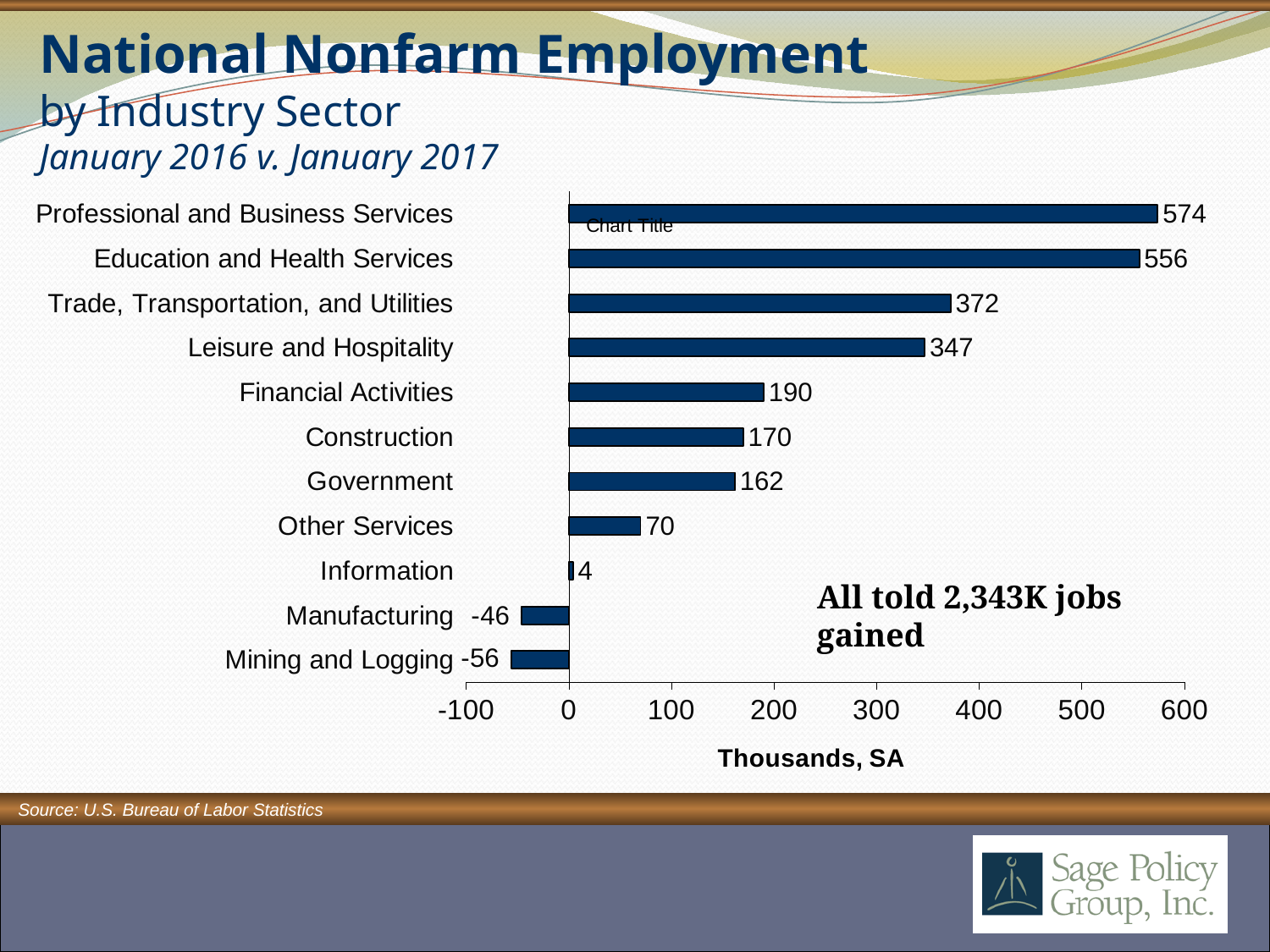
How many industry sectors are shown in the chart? 11 Which industry sector has the lowest value? Mining and Logging Which is larger, the value for Construction or the value for Government? Construction What kind of chart is shown on the slide? bar chart Which industry sector has the highest value? Professional and Business Services What is the difference between the values for Professional and Business Services and Education and Health Services? 18 Is the value for Financial Activities greater or less than 200? less What is the difference between the values for Trade, Transportation, and Utilities and Leisure and Hospitality? 25 What is the label of the horizontal axis? Thousands, SA What is the value for Professional and Business Services? 574 What is the value for Government? 162 What is the value for Mining and Logging? -56